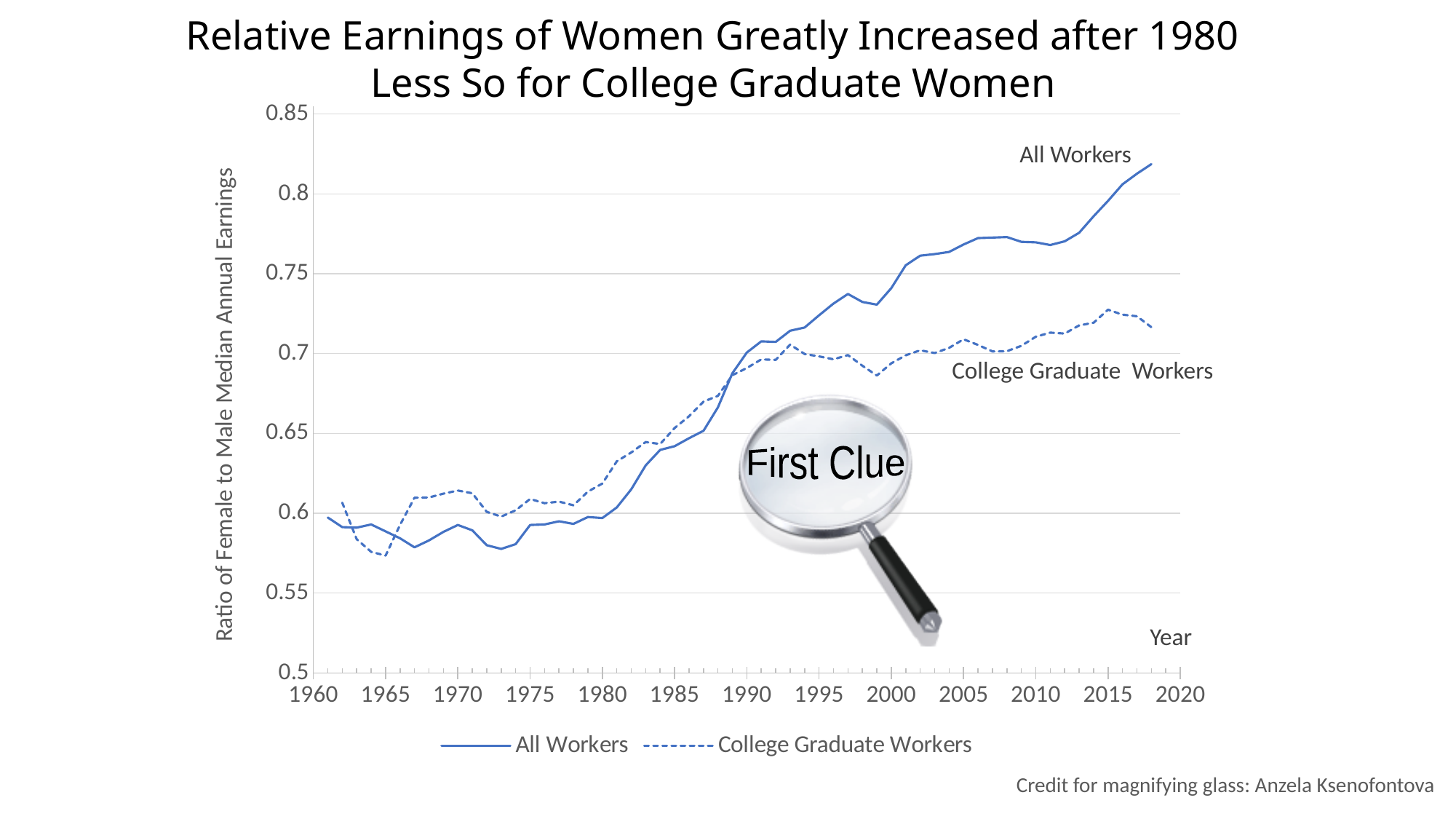
What kind of chart is shown on the slide? line chart Is the value for All Workers in 1970 greater or less than 0.55? greater What is the label of the vertical axis? Ratio of Female to Male Median Annual Earnings In 2018, which series has the higher value, All Workers or College Graduate Workers? All Workers How many series does the legend list? 2 In 2010, which series has the higher value, All Workers or College Graduate Workers? All Workers Does the All Workers line generally rise or fall between 1980 and 2018? rise Is the value for College Graduate Workers in 2015 greater or less than 0.7? greater Is the value for All Workers in 2018 greater or less than 0.8? greater Which series is plotted with a dashed line? College Graduate Workers